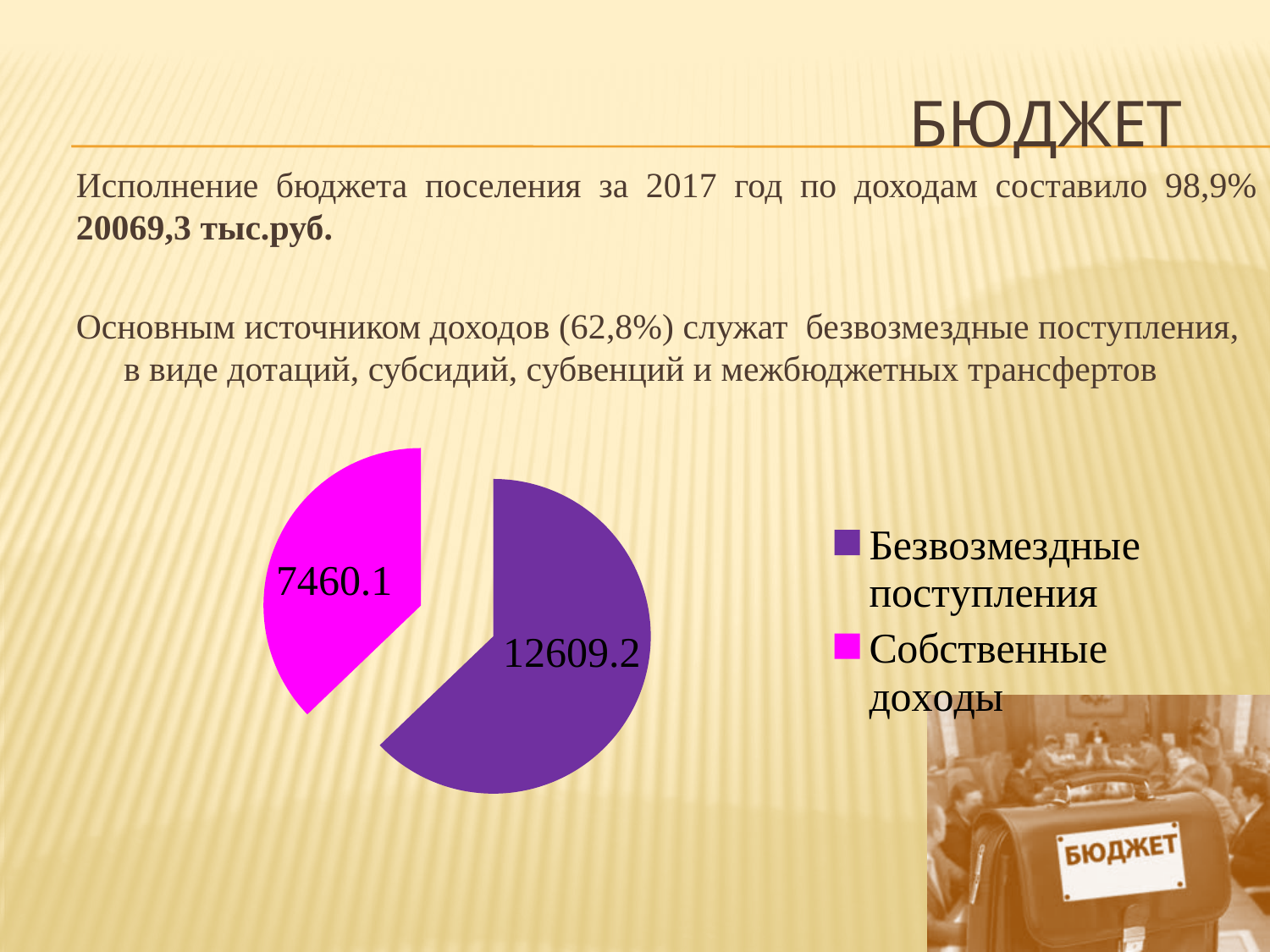
What is the value for Безвозмездные поступления in the pie chart? 12609.2 What is the total of the two slices in the pie chart? 20069.3 Which category has the largest slice in the pie chart? Безвозмездные поступления How many slices does the pie chart have? 2 What type of chart is shown on the slide? pie chart Which category has the smallest slice in the pie chart? Собственные доходы What is the difference between the values for Безвозмездные поступления and Собственные доходы? 5149.1 What is the value for Собственные доходы in the pie chart? 7460.1 Which is larger: Безвозмездные поступления or Собственные доходы? Безвозмездные поступления How many entries does the legend of the pie chart list? 2 What colour is the slice for Собственные доходы in the pie chart? magenta What share of the pie does Безвозмездные поступления represent? 62.8%